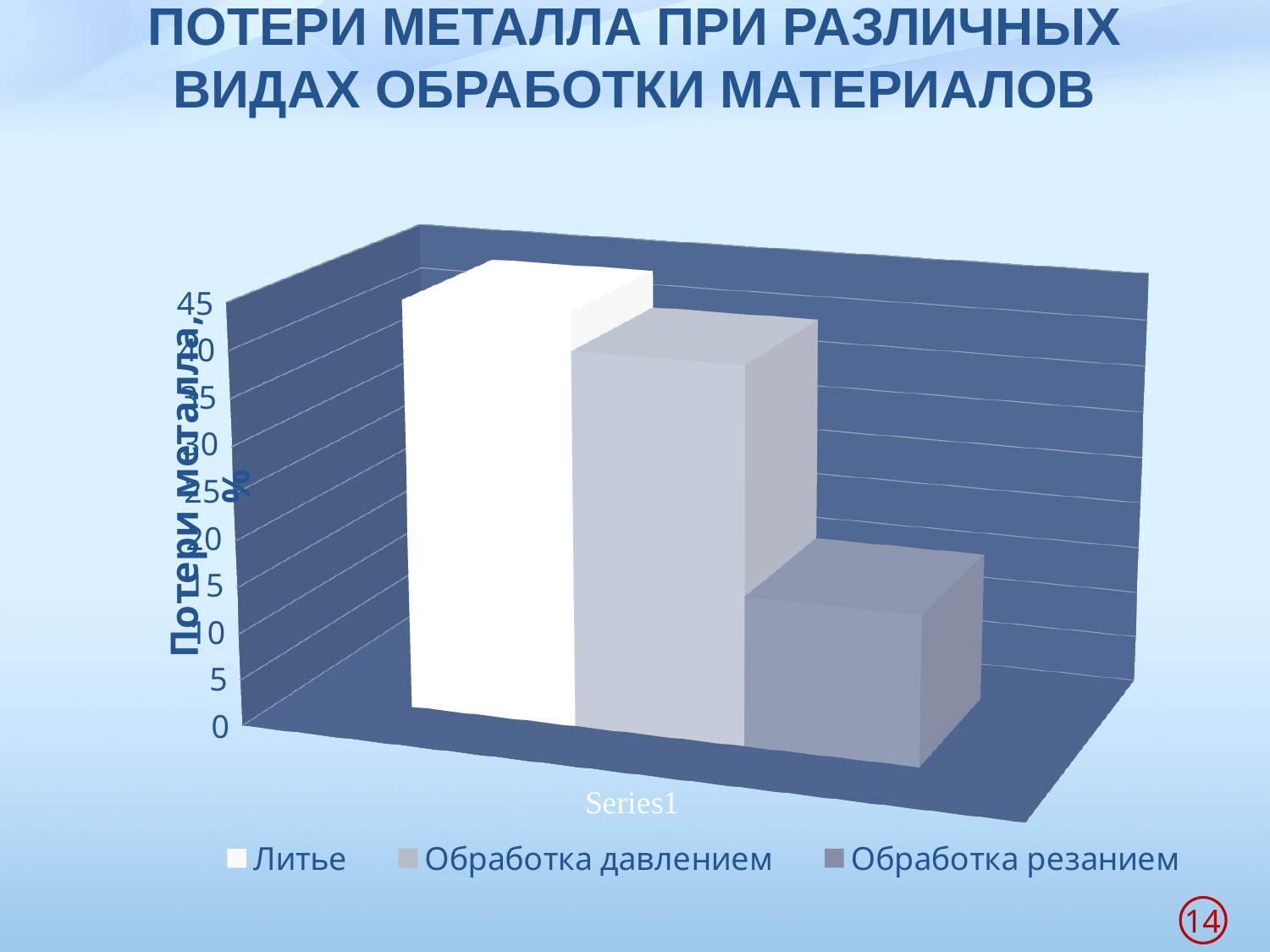
Which is larger, the value for Литье or the value for Обработка резанием? Литье Which is larger, the value for Обработка давлением or the value for Обработка резанием? Обработка давлением Which series has the lowest value? Обработка резанием What is the title of the slide? ПОТЕРИ МЕТАЛЛА ПРИ РАЗЛИЧНЫХ ВИДАХ ОБРАБОТКИ МАТЕРИАЛОВ Which series has the highest value? Литье What is the label of the vertical axis? Потери металла, % Is the value for Обработка резанием greater or less than 25? less How many series does the legend list? 3 Is the value for Обработка давлением greater or less than 25? greater What is the highest value shown on the vertical axis? 45 Is the value for Литье greater or less than 30? greater What kind of chart is shown on the slide? bar chart